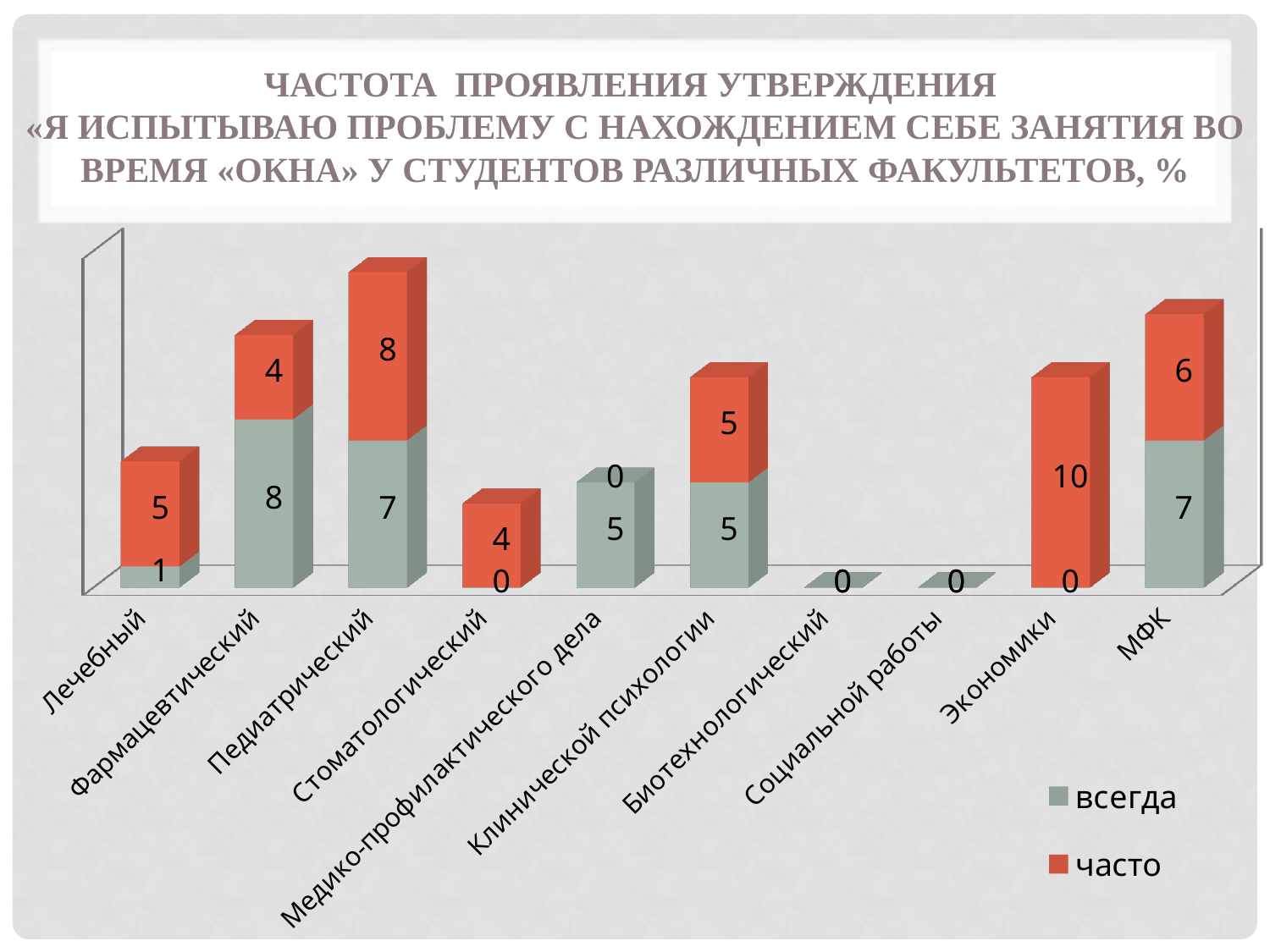
Which faculty has the highest stacked total? Педиатрический What is the value of the "всегда" series for Фармацевтический? 8 What is the difference between the "всегда" values for Фармацевтический and Лечебный? 7 How many series does the legend list? 2 How many faculties (categories) are shown on the x axis? 10 What is the value of the "часто" series for Педиатрический? 8 Which is larger: the "часто" value for МФК or the "часто" value for Стоматологический? МФК What is the stacked total for МФК? 13 What is the value of the "часто" series for Экономики? 10 What is the stacked total for Клинической психологии? 10 What is the value of the "всегда" series for Лечебный? 1 Which faculty has the highest value in the "часто" series? Экономики